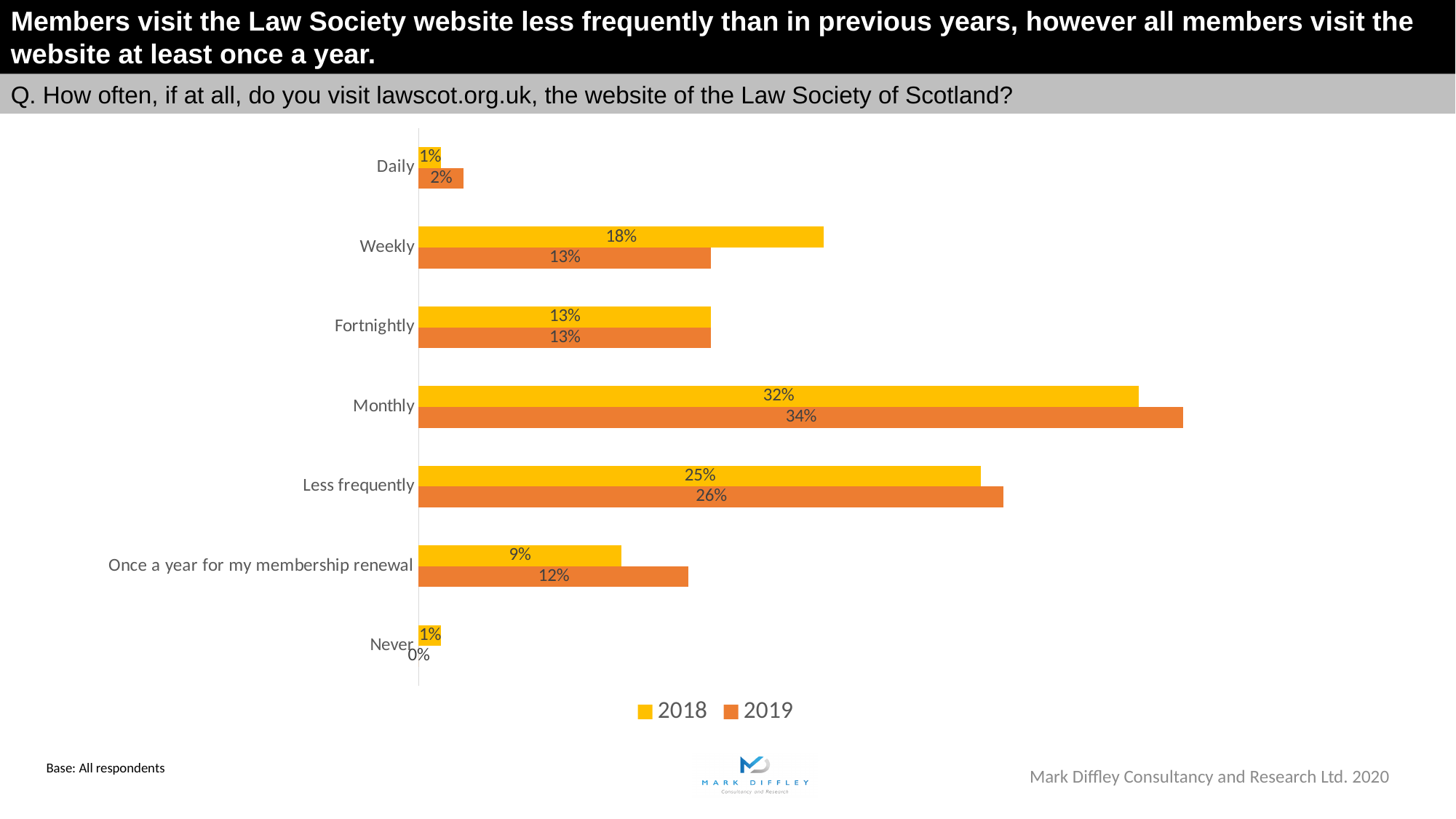
Which colour represents 2019 in the chart? Orange How many series does the legend list? 2 Which visit frequency has the lowest value for 2019? Never What is the 2019 value for 'Once a year for my membership renewal'? 12% How many visit frequency categories are shown on the chart? 7 Which visit frequency has the highest value for 2019? Monthly What is the difference between the 2018 and 2019 values for Monthly? 2% What is the difference between the 2018 and 2019 values for Weekly? 5% Which is larger for 'Less frequently': the 2018 value or the 2019 value? 2019 What percentage of members visited the website monthly in 2019? 34% What percentage of members visited the website weekly in 2018? 18% What kind of chart is shown on the slide? Bar chart